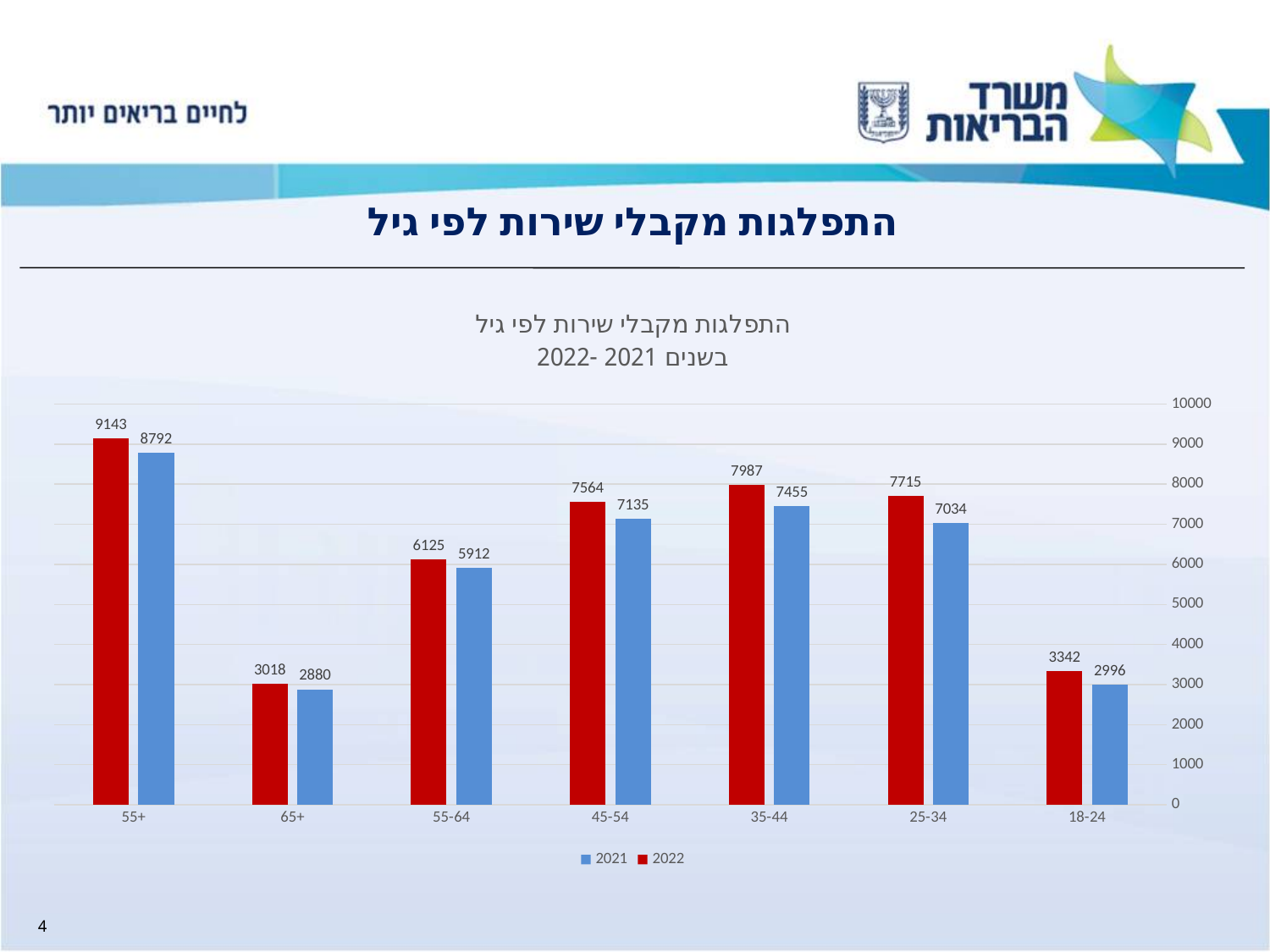
Which is larger: the 2022 value for 25-34 or the 2022 value for 45-54? 25-34 What is the value for 2021 in the 45-54 age group? 7135 Which colour represents the 2021 series in the legend? blue Which age group has the lowest value for 2021? 65+ How many series does the legend list? 2 Is the 2021 value for the 55-64 age group greater or less than 6000? less What kind of chart is shown on the slide? bar chart What is the value for 2021 in the 18-24 age group? 2996 How many age groups are shown on the x axis? 7 What is the value for 2022 in the 55+ age group? 9143 Which age group has the highest value for 2022? 55+ What is the difference between the 2022 and 2021 values for the 35-44 age group? 532